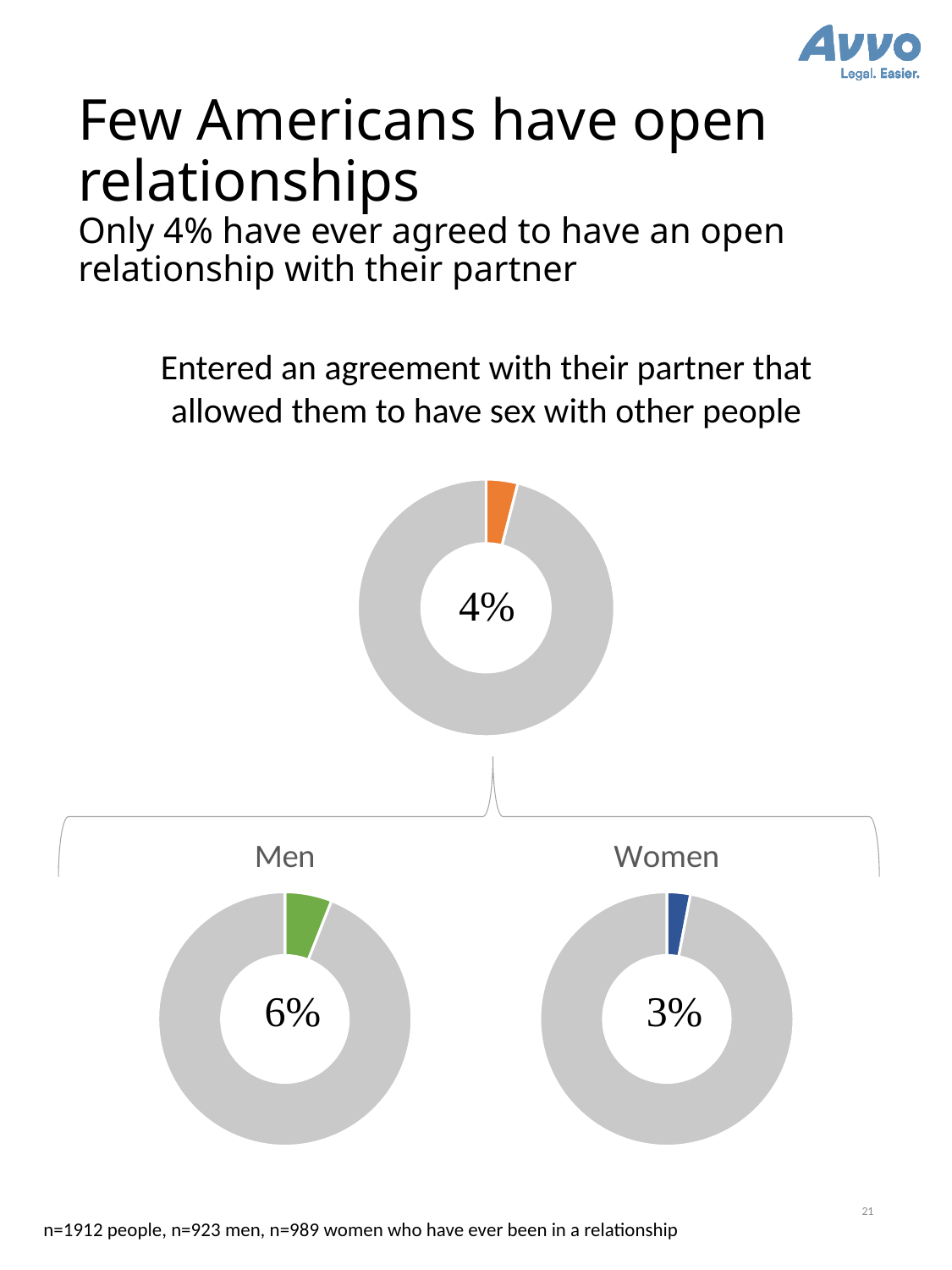
What is the difference in percentage points between the Men donut chart and the Women donut chart? 3 In the Women donut chart, what percentage is shown? 3% What kind of chart is used to show the percentages on this slide? Donut (pie) chart What colour is the highlighted slice in the Men donut chart? Green What is the title of the top donut chart? Entered an agreement with their partner that allowed them to have sex with other people How many donut charts are shown on the slide? 3 What is the difference in percentage points between the Men donut chart and the top overall donut chart? 2 In the top donut chart, what share of the whole does the orange slice represent? 4% Comparing the Men and Women donut charts, which group has the higher percentage? Men Comparing the Men and Women donut charts, which group has the lower percentage? Women In the Men donut chart, what percentage is shown? 6% In the top donut chart, what percentage entered an agreement with their partner that allowed them to have sex with other people? 4%